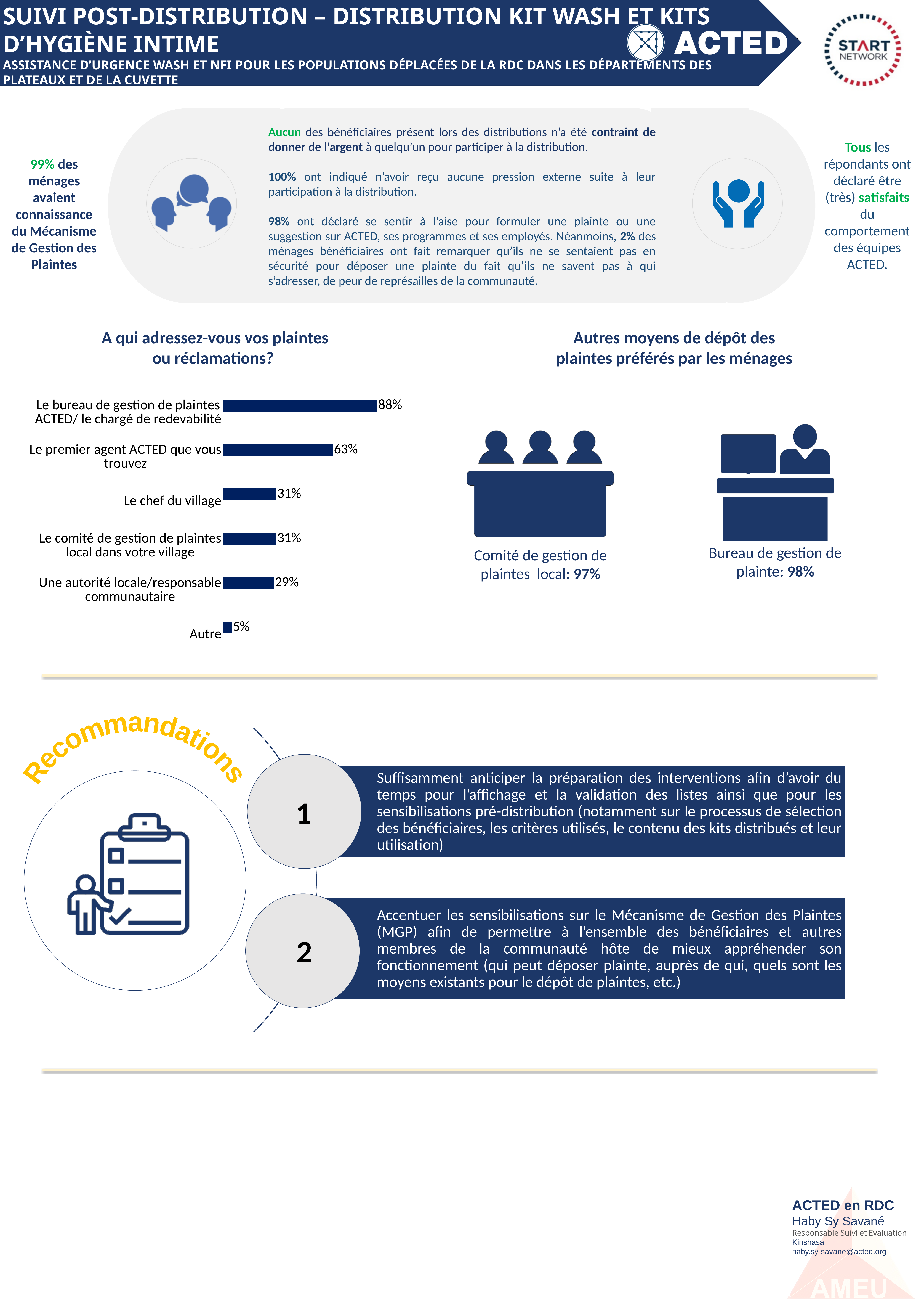
In the chart 'A qui adressez-vous vos plaintes ou réclamations?', what is the difference between the values for 'Le comité de gestion de plaintes local dans votre village' and 'Autre'? 26% In the chart 'A qui adressez-vous vos plaintes ou réclamations?', what is the value for 'Le premier agent ACTED que vous trouvez'? 63% In the chart 'A qui adressez-vous vos plaintes ou réclamations?', which category has the highest value? Le bureau de gestion de plaintes ACTED/ le chargé de redevabilité In the chart 'A qui adressez-vous vos plaintes ou réclamations?', what is the value for 'Le bureau de gestion de plaintes ACTED/ le chargé de redevabilité'? 88% What kind of chart is 'A qui adressez-vous vos plaintes ou réclamations?'? Bar chart How many categories are shown in the chart 'A qui adressez-vous vos plaintes ou réclamations?'? 6 In the chart 'A qui adressez-vous vos plaintes ou réclamations?', what is the value for 'Le chef du village'? 31% In the chart 'A qui adressez-vous vos plaintes ou réclamations?', what is the difference between the values for 'Le bureau de gestion de plaintes ACTED/ le chargé de redevabilité' and 'Le premier agent ACTED que vous trouvez'? 25% In the chart 'A qui adressez-vous vos plaintes ou réclamations?', which is larger: the value for 'Le chef du village' or the value for 'Une autorité locale/responsable communautaire'? Le chef du village In the chart 'A qui adressez-vous vos plaintes ou réclamations?', which category has the lowest value? Autre In the chart 'A qui adressez-vous vos plaintes ou réclamations?', what is the value for 'Autre'? 5% In the chart 'A qui adressez-vous vos plaintes ou réclamations?', what is the value for 'Une autorité locale/responsable communautaire'? 29%